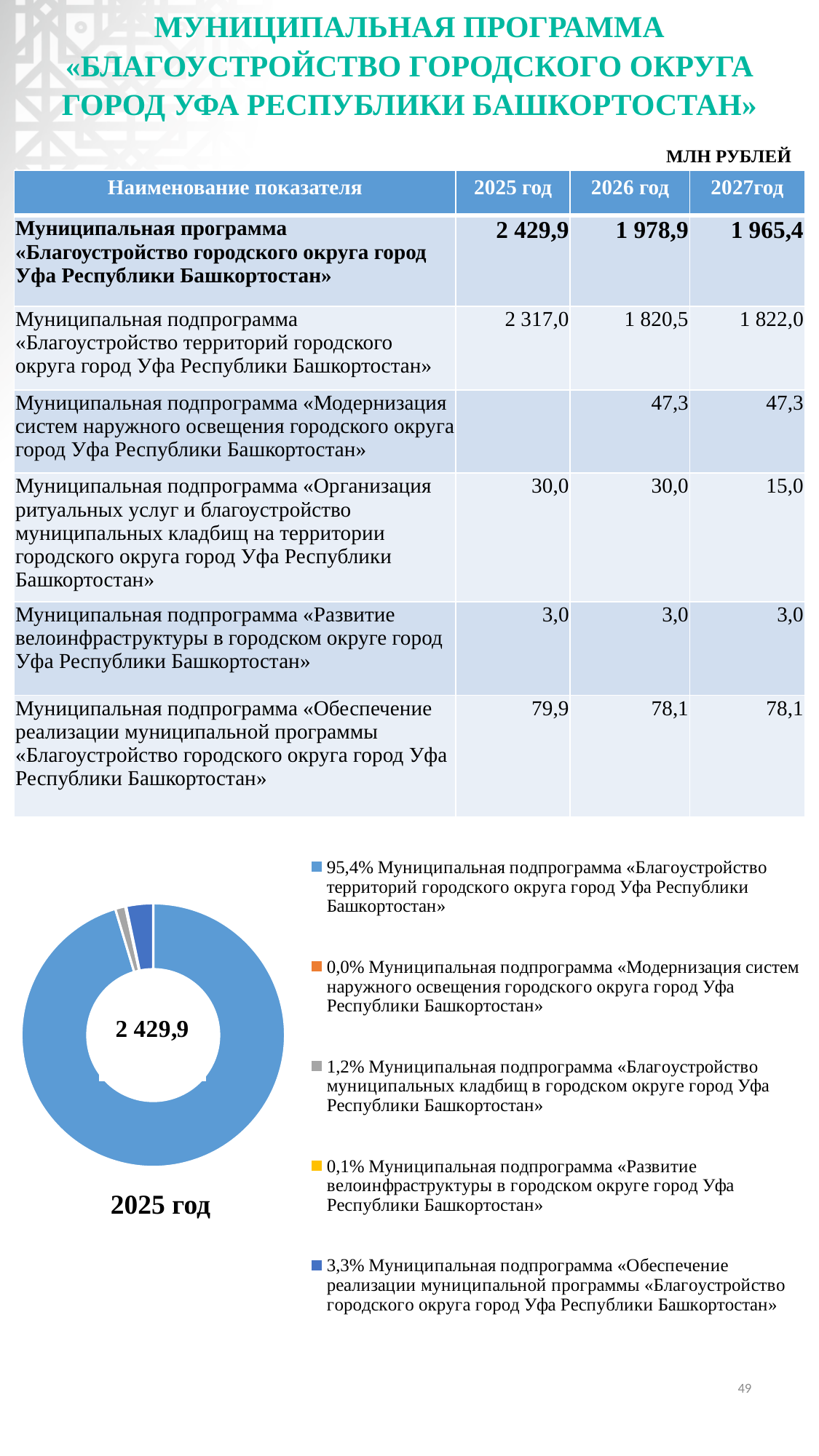
Which share is larger in the doughnut chart: «Обеспечение реализации муниципальной программы» or «Благоустройство муниципальных кладбищ»? «Обеспечение реализации муниципальной программы» (3,3%) What share of the doughnut chart does the subprogram «Благоустройство муниципальных кладбищ» have? 1,2% What kind of chart is shown at the bottom of the slide? Doughnut (pie) chart Which legend entry has the largest share in the doughnut chart? Муниципальная подпрограмма «Благоустройство территорий городского округа город Уфа Республики Башкортостан» What share of the doughnut chart does the subprogram «Благоустройство территорий городского округа город Уфа Республики Башкортостан» have? 95,4% What share of the doughnut chart does the subprogram «Обеспечение реализации муниципальной программы» have? 3,3% How many entries does the legend of the doughnut chart list? 5 Which legend entry has the smallest share in the doughnut chart? Муниципальная подпрограмма «Модернизация систем наружного освещения городского округа город Уфа Республики Башкортостан» What total value is printed in the centre of the doughnut chart? 2 429,9 Which year does the doughnut chart represent, according to its caption? 2025 год